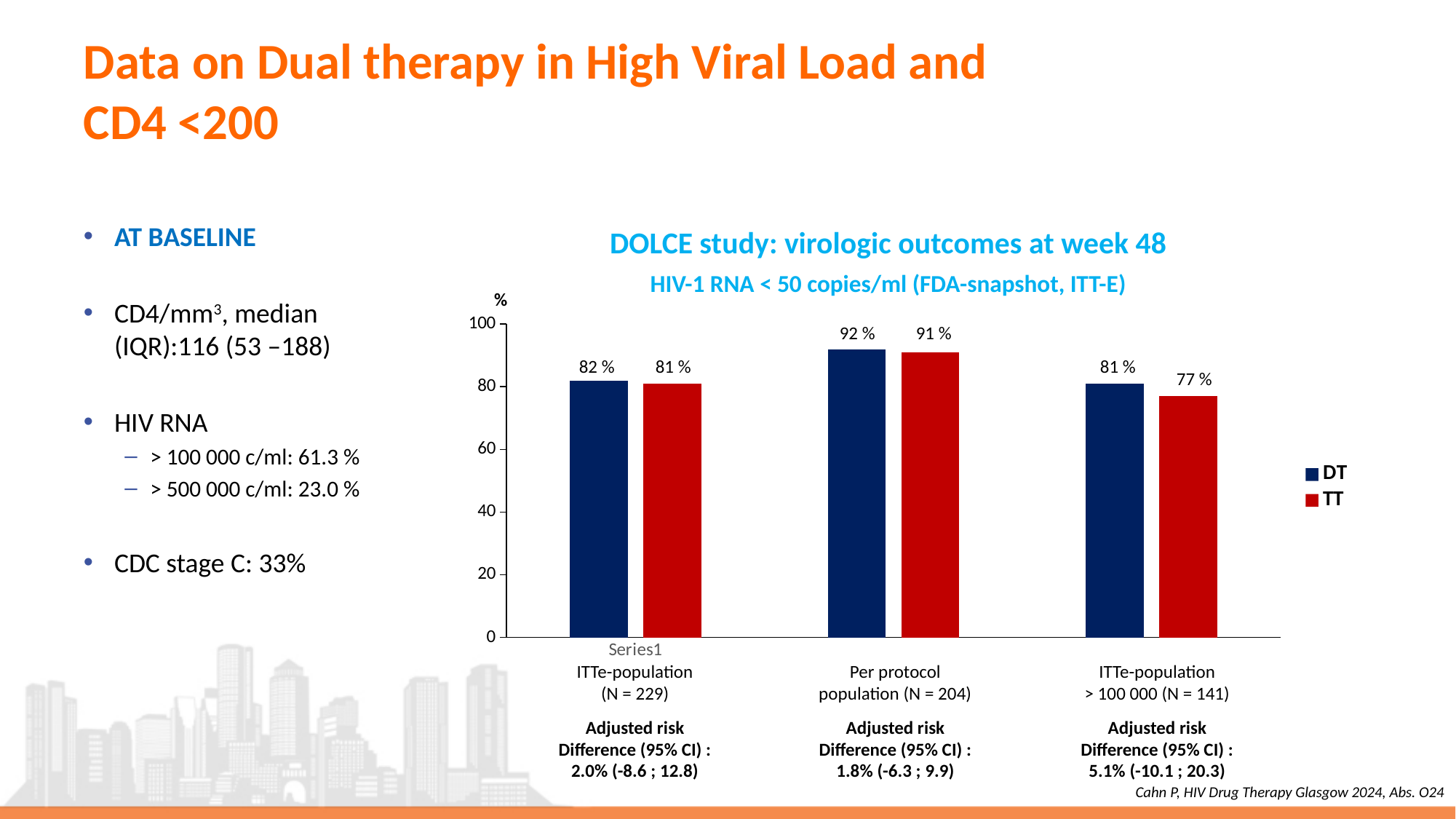
In which group is the TT value lowest? ITTe-population > 100 000 (N = 141) What is the title of the chart? DOLCE study: virologic outcomes at week 48 How many groups of bars are shown on the chart? 3 In the Per protocol population (N = 204) group, which is larger, the DT value or the TT value? DT What is the TT value for the Per protocol population (N = 204) group? 91 % What is the TT value for the ITTe-population > 100 000 (N = 141) group? 77 % What is the DT value for the ITTe-population (N = 229) group? 82 % What is the difference between the DT and TT values in the ITTe-population > 100 000 (N = 141) group? 4 % In which group is the DT value highest? Per protocol population (N = 204) What kind of chart is shown on the slide? Bar chart How many series does the legend list? 2 What is the DT value for the ITTe-population > 100 000 (N = 141) group? 81 %